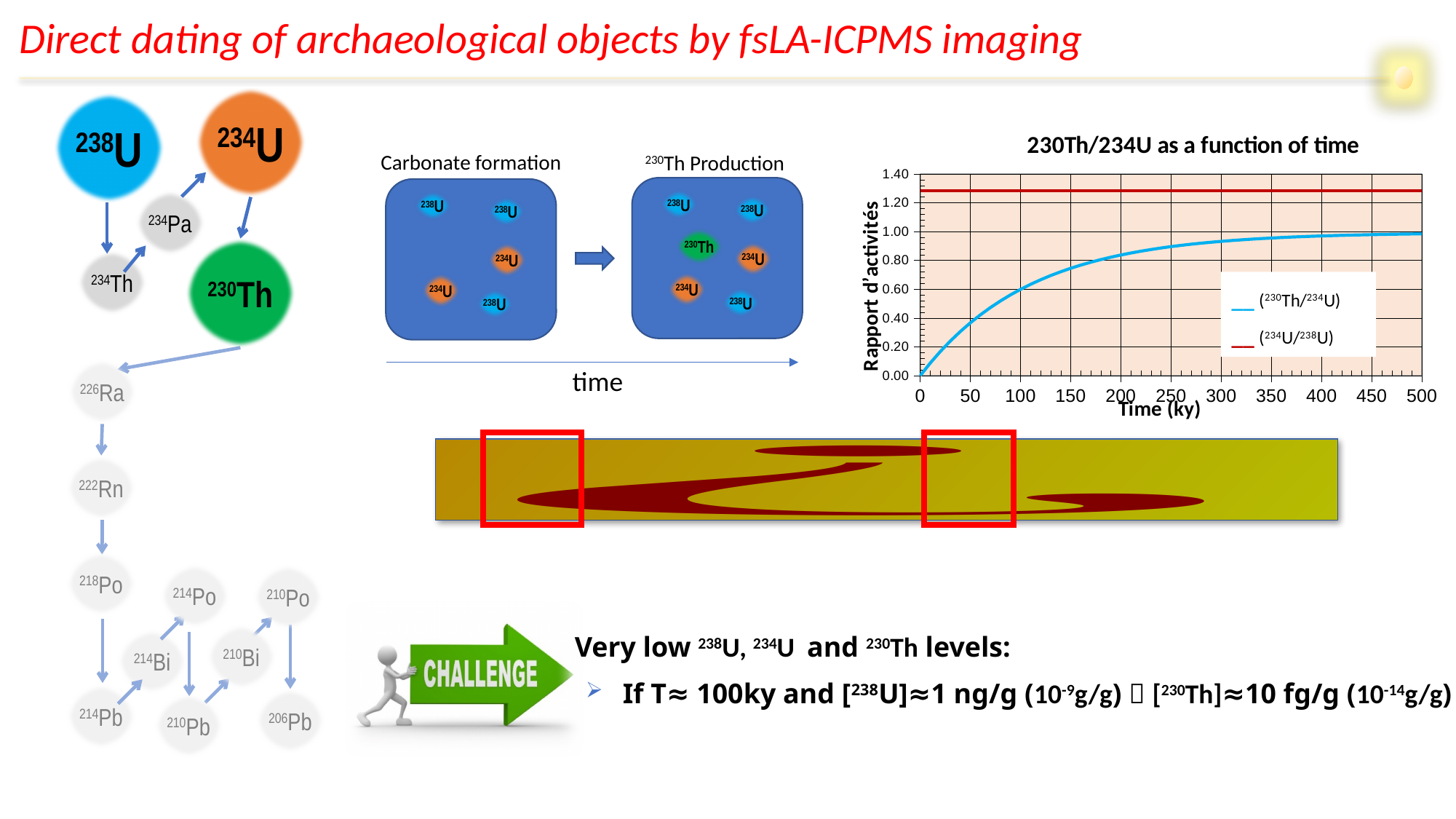
How many series does the legend of the '230Th/234U as a function of time' chart list? 2 In the '230Th/234U as a function of time' chart, what is the value of the (230Th/234U) series at time 0? 0.00 In the '230Th/234U as a function of time' chart, is the (230Th/234U) value at 50 ky greater or less than 0.60? less What is the title of the chart on the right of the slide? 230Th/234U as a function of time In the '230Th/234U as a function of time' chart, is the (230Th/234U) value at 300 ky greater or less than 0.80? greater In the '230Th/234U as a function of time' chart, is the (230Th/234U) value at 500 ky greater or less than 1.20? less In the '230Th/234U as a function of time' chart, which series has the higher value at 200 ky, (230Th/234U) or (234U/238U)? (234U/238U) In the '230Th/234U as a function of time' chart, does the (230Th/234U) series rise or fall as time increases? rise What type of chart is '230Th/234U as a function of time'? line chart What is the x-axis label of the '230Th/234U as a function of time' chart? Time (ky)